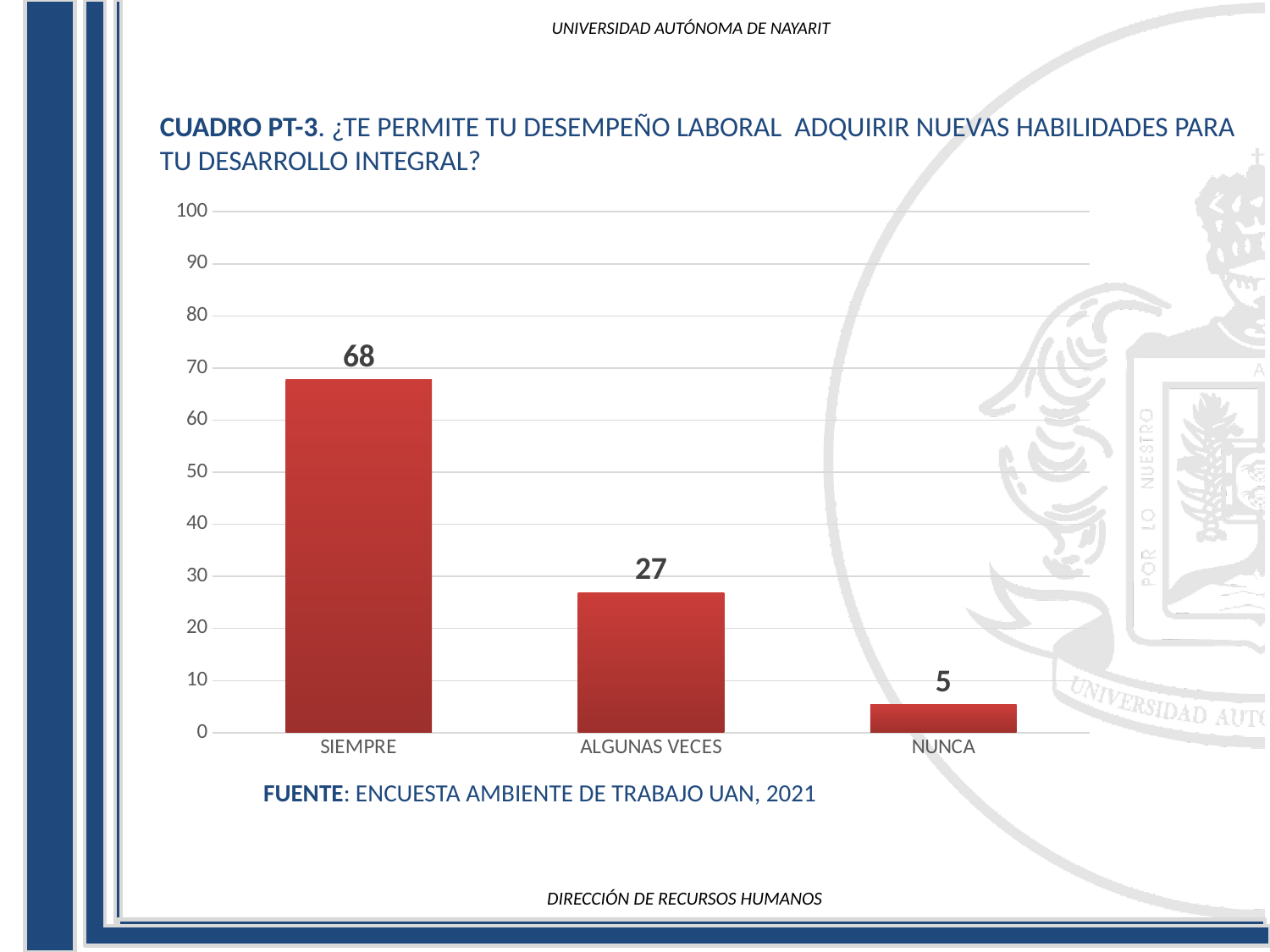
What is the value for ALGUNAS VECES? 27 What kind of chart is shown on the slide? bar chart Do the values rise or fall from left to right along the x axis? fall What is the difference between the values for SIEMPRE and ALGUNAS VECES? 41 Is the value for SIEMPRE greater or less than 60? greater Which is larger, the value for ALGUNAS VECES or the value for NUNCA? ALGUNAS VECES What is the value for SIEMPRE? 68 Which category has the lowest value? NUNCA What is the difference between the values for ALGUNAS VECES and NUNCA? 22 Which category has the highest value? SIEMPRE What is the value for NUNCA? 5 How many categories are shown on the x axis? 3